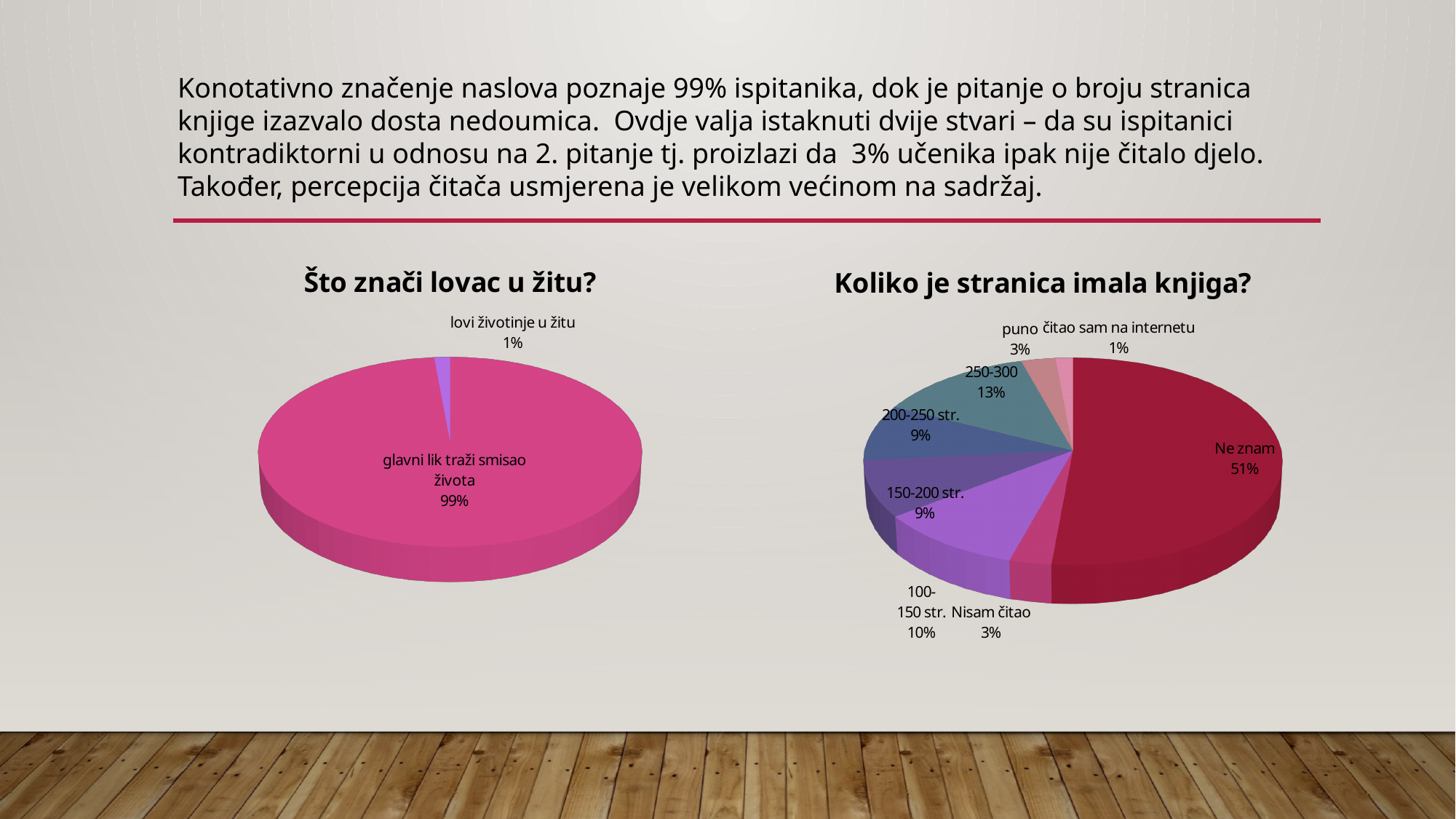
What kind of chart is the chart titled "Koliko je stranica imala knjiga?"? Pie chart In the chart titled "Koliko je stranica imala knjiga?", which category has the smallest share? čitao sam na internetu In the chart titled "Koliko je stranica imala knjiga?", how many slices are there? 8 In the chart titled "Koliko je stranica imala knjiga?", what is the difference in percentage points between "Ne znam" and "250-300"? 38 How many slices does the chart titled "Što znači lovac u žitu?" have? 2 In the chart titled "Koliko je stranica imala knjiga?", what share of respondents answered "100-150 str."? 10% In the chart titled "Što znači lovac u žitu?", what share of respondents answered "lovi životinje u žitu"? 1% In the chart titled "Što znači lovac u žitu?", what share of respondents answered "glavni lik traži smisao života"? 99% In the chart titled "Koliko je stranica imala knjiga?", which is larger: the share for "100-150 str." or the share for "150-200 str."? 100-150 str. In the chart titled "Koliko je stranica imala knjiga?", which category has the largest share? Ne znam